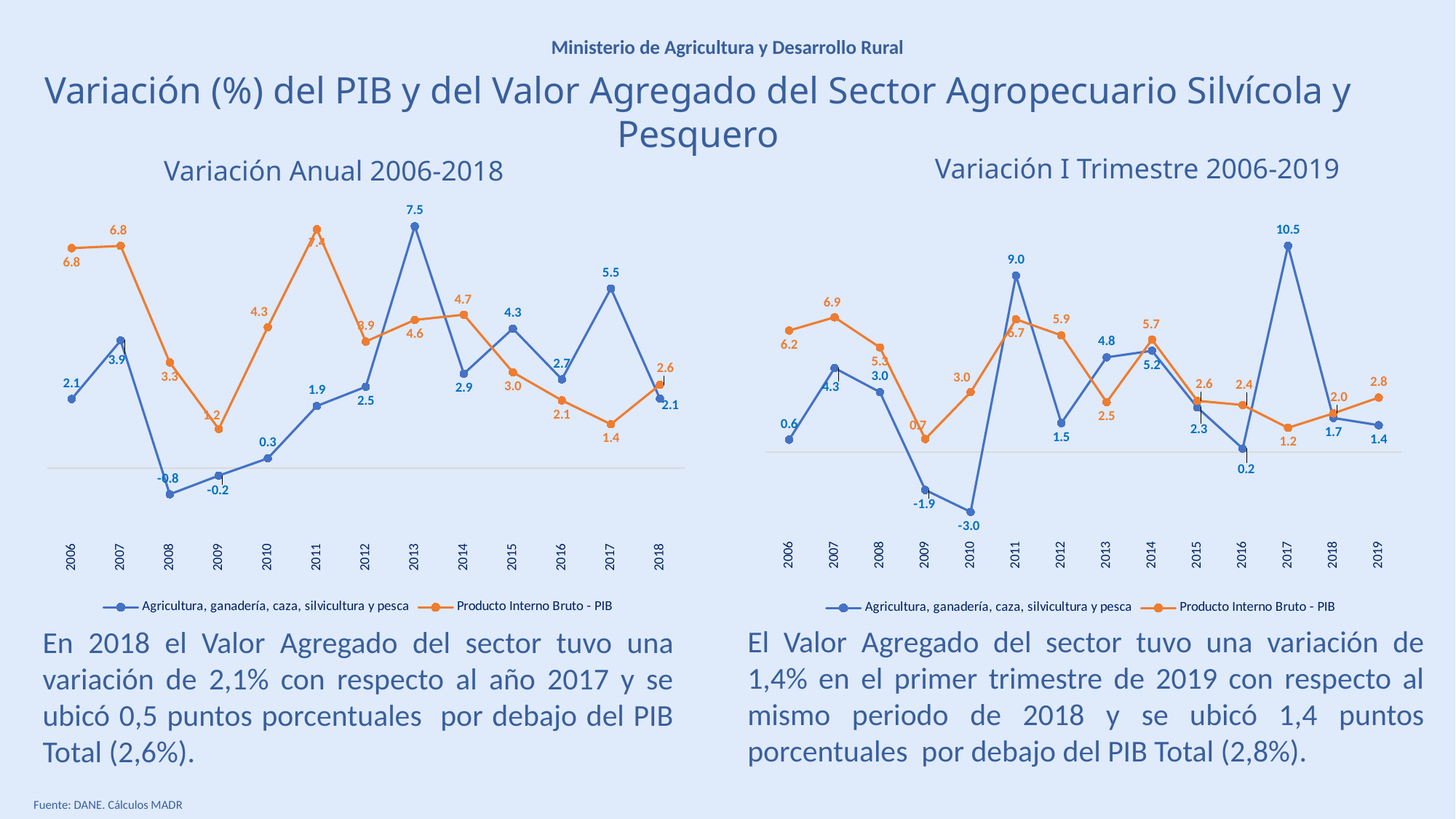
In the 'Variación I Trimestre 2006-2019' chart, what is the difference between the PIB value and the Agricultura value in 2019? 1.4 In the 'Variación Anual 2006-2018' chart, which year has the lowest value for Agricultura, ganadería, caza, silvicultura y pesca? 2008 What type of chart is the 'Variación I Trimestre 2006-2019' chart? Line chart In the 'Variación Anual 2006-2018' chart, what is the value for Agricultura, ganadería, caza, silvicultura y pesca in 2013? 7.5 In the 'Variación Anual 2006-2018' chart, what is the difference between the PIB value and the Agricultura value in 2018? 0.5 In the 'Variación I Trimestre 2006-2019' chart, what is the value for Agricultura, ganadería, caza, silvicultura y pesca in 2017? 10.5 How many series does the legend of the 'Variación Anual 2006-2018' chart list? 2 In the 'Variación Anual 2006-2018' chart, how many years are shown on the x axis? 13 In the 'Variación I Trimestre 2006-2019' chart, which year has the highest value for Producto Interno Bruto - PIB? 2007 In the 'Variación Anual 2006-2018' chart, what is the value for Producto Interno Bruto - PIB in 2018? 2.6 In the 'Variación I Trimestre 2006-2019' chart, what is the lowest value for Agricultura, ganadería, caza, silvicultura y pesca? -3.0 In the 'Variación Anual 2006-2018' chart, which series has the larger value in 2017, Agricultura or PIB? Agricultura, ganadería, caza, silvicultura y pesca